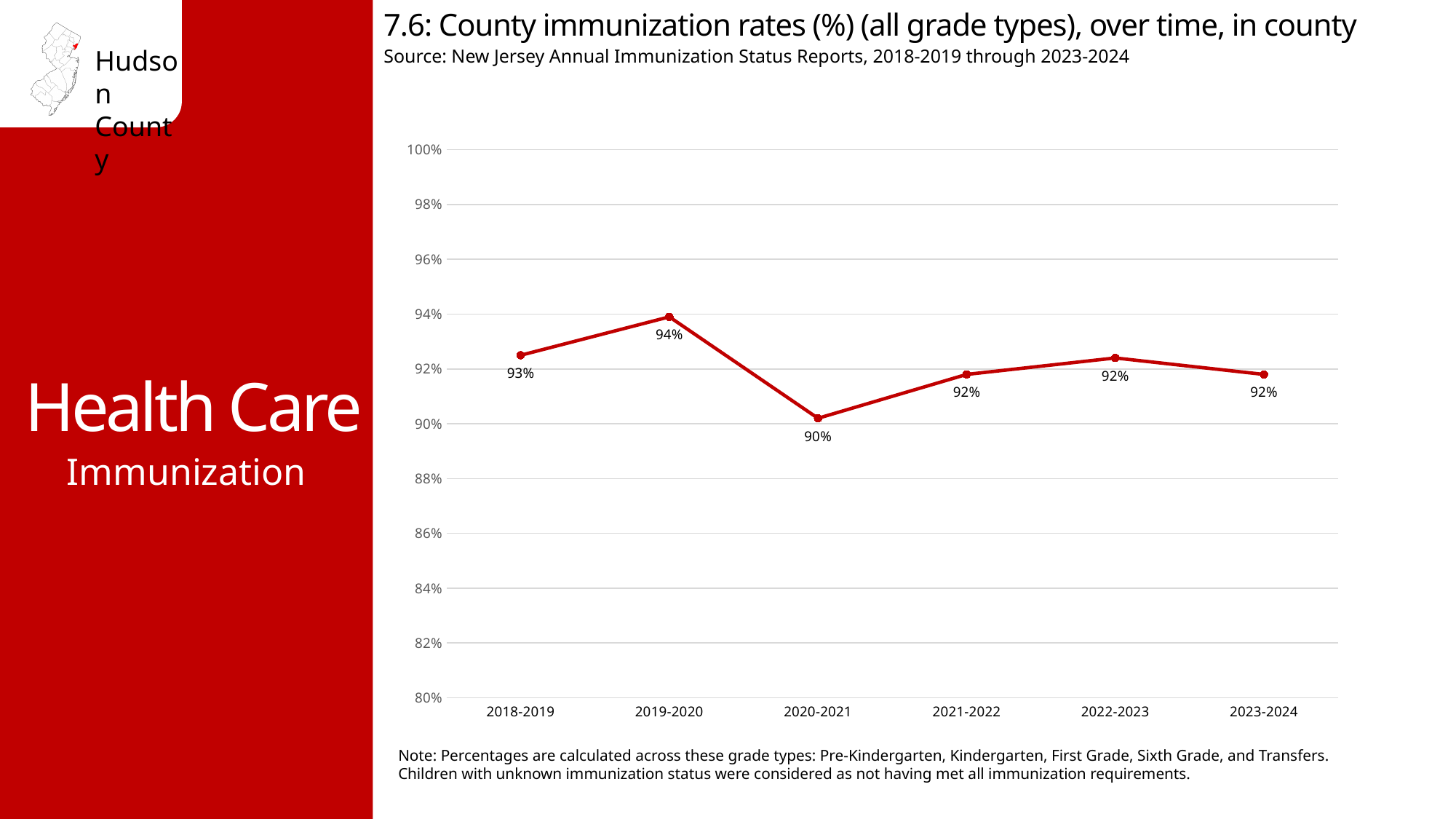
Which school year has the lowest immunization rate? 2020-2021 Which is larger, the immunization rate in 2018-2019 or in 2020-2021? 2018-2019 How many school years are plotted on the chart? 6 What is the county immunization rate for 2018-2019? 93% Which school year has the highest immunization rate? 2019-2020 What kind of chart is shown on the slide? Line chart What is the difference between the immunization rate in 2019-2020 and in 2020-2021? 4 percentage points Did the immunization rate rise or fall from 2019-2020 to 2020-2021? Fall What is the county immunization rate for 2023-2024? 92% What is the county immunization rate for 2020-2021? 90% What is the county immunization rate for 2019-2020? 94% Is the immunization rate for 2020-2021 greater or less than 92%? less